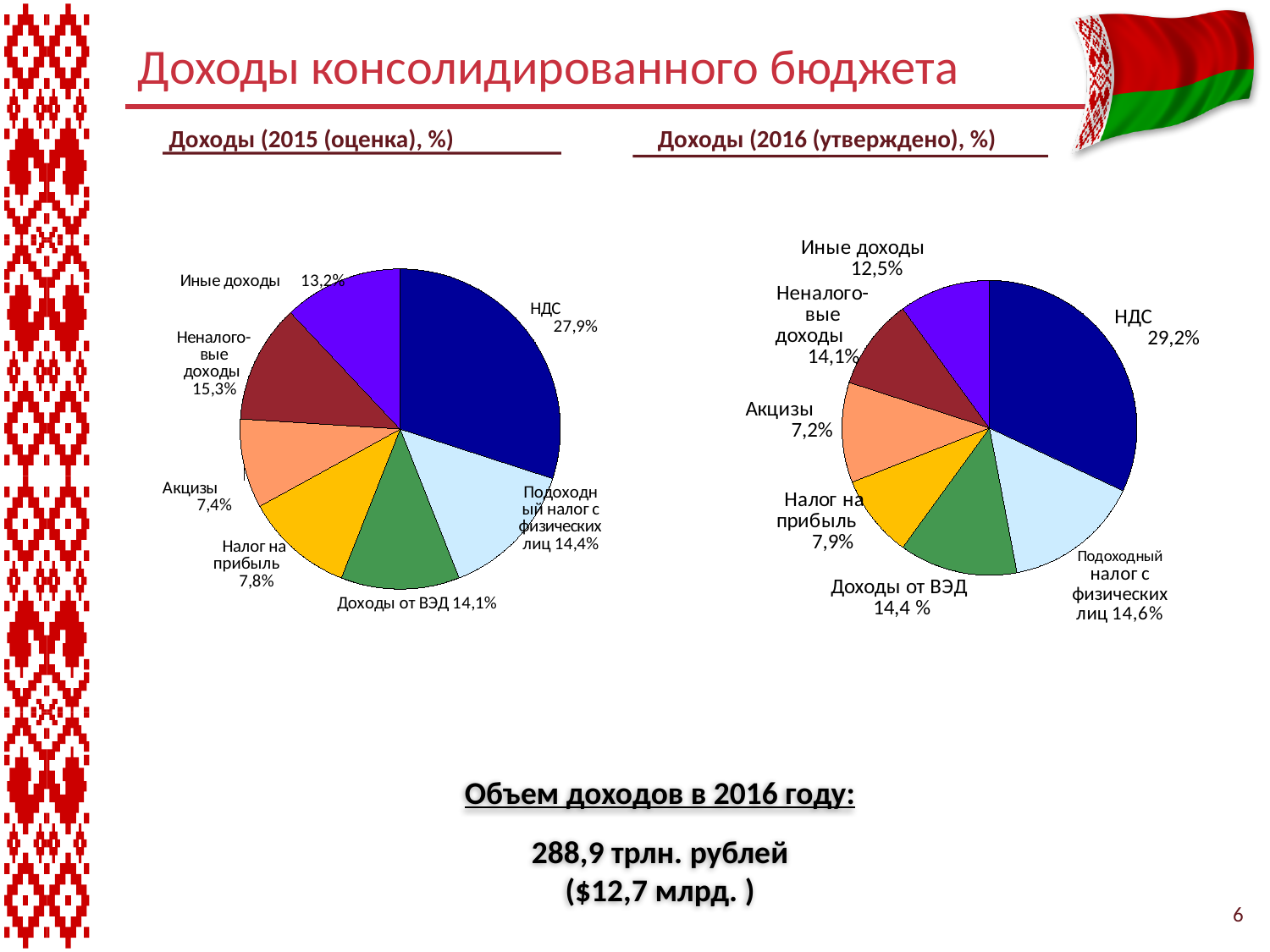
In the chart titled "Доходы (2016 (утверждено), %)", what is the value for Иные доходы? 12,5% In the chart titled "Доходы (2016 (утверждено), %)", what is the difference between the НДС share and the Иные доходы share? 16,7% In the chart titled "Доходы (2015 (оценка), %)", what is the value for НДС? 27,9% In the chart titled "Доходы (2015 (оценка), %)", which category has the smallest share? Акцизы In the chart titled "Доходы (2016 (утверждено), %)", what is the value for Акцизы? 7,2% In the chart titled "Доходы (2015 (оценка), %)", what is the value for Неналоговые доходы? 15,3% In the chart titled "Доходы (2015 (оценка), %)", what is the combined share of Налог на прибыль and Акцизы? 15,2% What type of chart is used for "Доходы (2015 (оценка), %)"? Pie chart In the chart titled "Доходы (2015 (оценка), %)", which is larger: Налог на прибыль or Акцизы? Налог на прибыль In the chart titled "Доходы (2016 (утверждено), %)", which category has the largest share? НДС How many categories are shown in the chart titled "Доходы (2016 (утверждено), %)"? 7 What is the title of the right-hand chart on the slide? Доходы (2016 (утверждено), %)